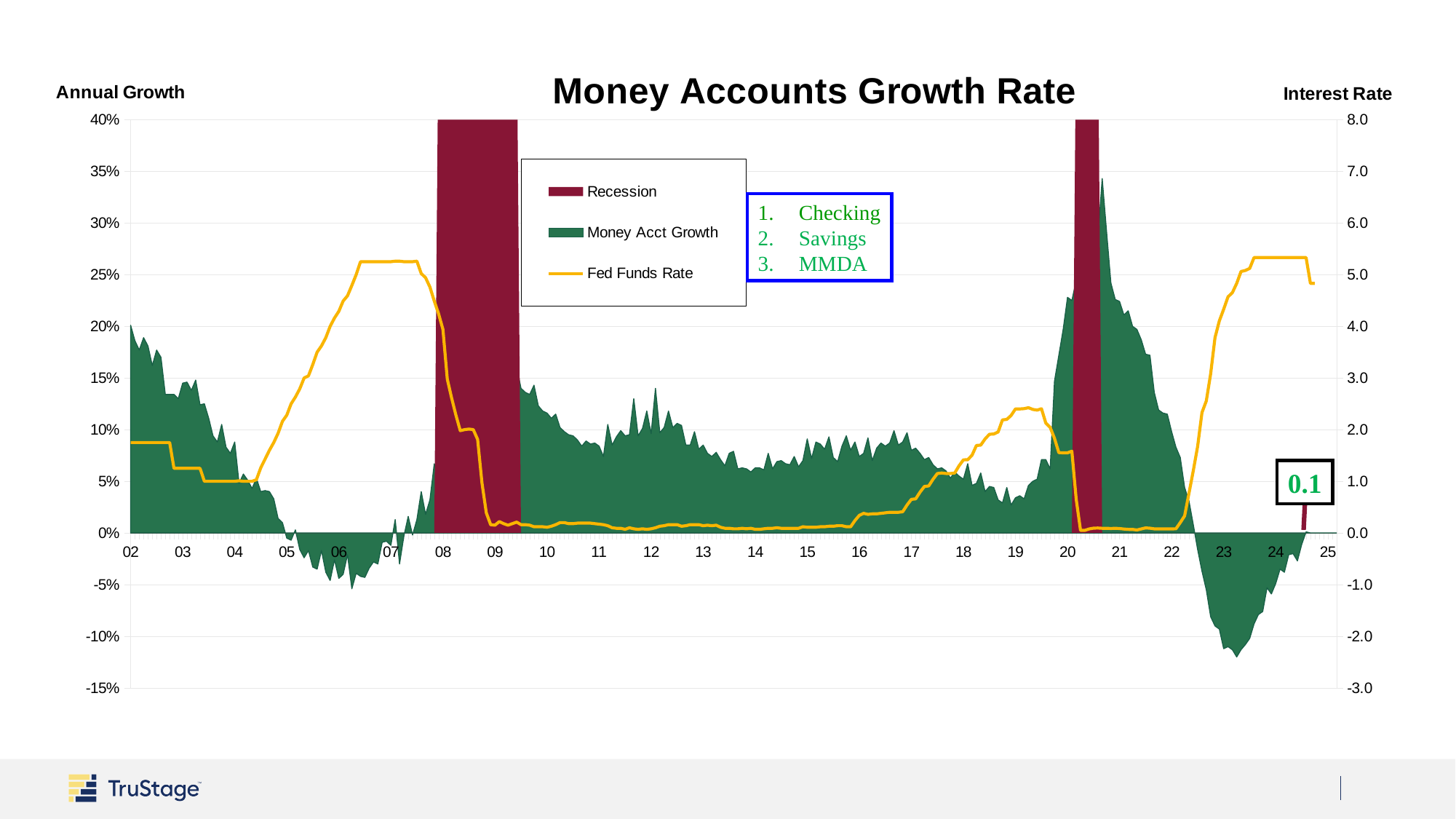
What is the title of the chart? Money Accounts Growth Rate How many entries does the chart's legend list? 3 Which is higher: the peak of Money Acct Growth around 2021 or the peak around 2002? 2021 Does the Fed Funds Rate rise or fall between 2022 and 2023? rise What value is printed in the data label at the right end of the Money Acct Growth series? 0.1 How many recession periods are shaded on the chart? 2 Is the Fed Funds Rate in 2010 greater or less than 1.0? less Does Money Acct Growth rise or fall between 2021 and 2023? fall Is the Fed Funds Rate in 2007 greater or less than 5.0? greater What kind of chart is used to plot the Money Acct Growth series? area chart Is the peak value of Money Acct Growth around 2021 greater or less than 30%? greater